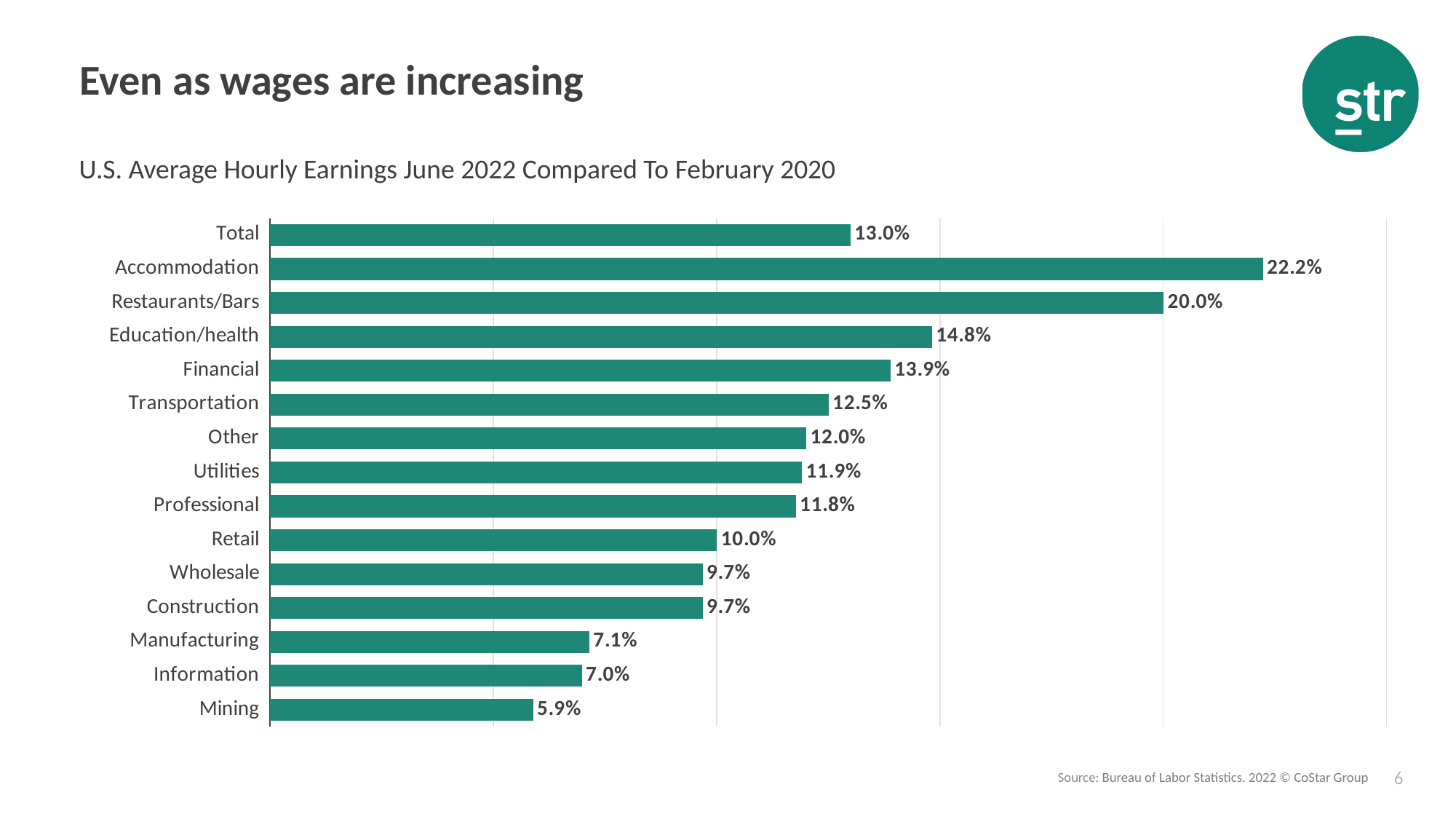
Which category has the lowest value? Mining What is the value for Accommodation? 22.2% What is the difference between the values for Education/health and Financial? 0.9% What is the difference between the values for Accommodation and Restaurants/Bars? 2.2% What is the value for Transportation? 12.5% What kind of chart is shown on the slide? Bar chart What is the value for Mining? 5.9% How many categories are shown in the chart? 15 Which is larger, the value for Retail or the value for Manufacturing? Retail What is the title of the chart? U.S. Average Hourly Earnings June 2022 Compared To February 2020 Which category has the highest value? Accommodation What is the value for Total? 13.0%